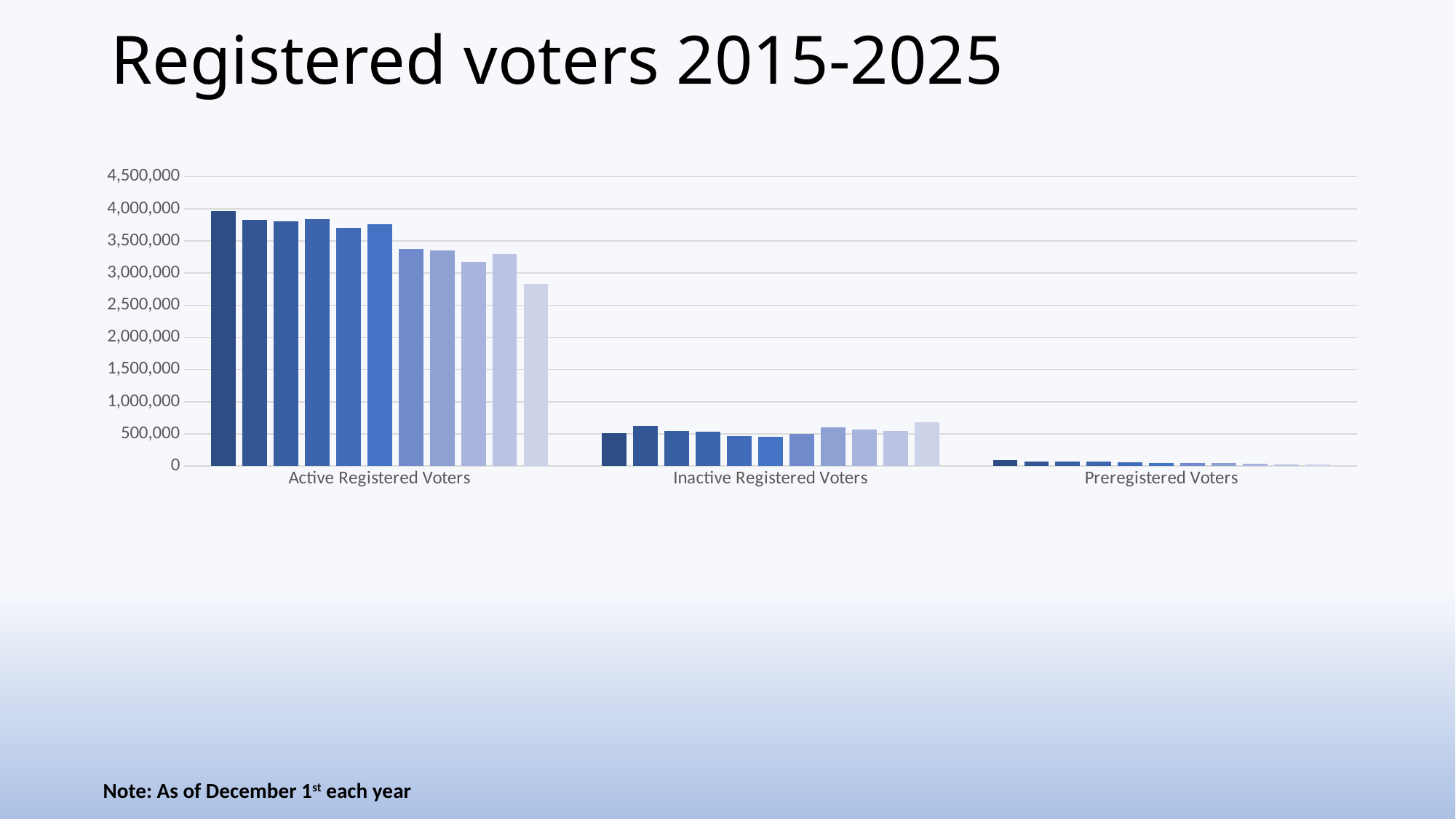
Which category has the lowest bars in the chart? Preregistered Voters Is the value of the leftmost bar for Active Registered Voters greater or less than 3,500,000? greater Is the value of the leftmost bar for Preregistered Voters greater or less than 500,000? less What kind of chart is shown on the slide? bar chart Is the value of the tallest bar for Inactive Registered Voters greater or less than 1,000,000? less Which category has the highest bars in the chart? Active Registered Voters How many bars are shown for each category in the chart? 11 Which is larger: the leftmost bar for Active Registered Voters or the leftmost bar for Inactive Registered Voters? Active Registered Voters What is the title of the slide containing the chart? Registered voters 2015-2025 How many categories are shown on the x axis of the chart? 3 Do the bars for Active Registered Voters generally rise or fall from left to right? fall